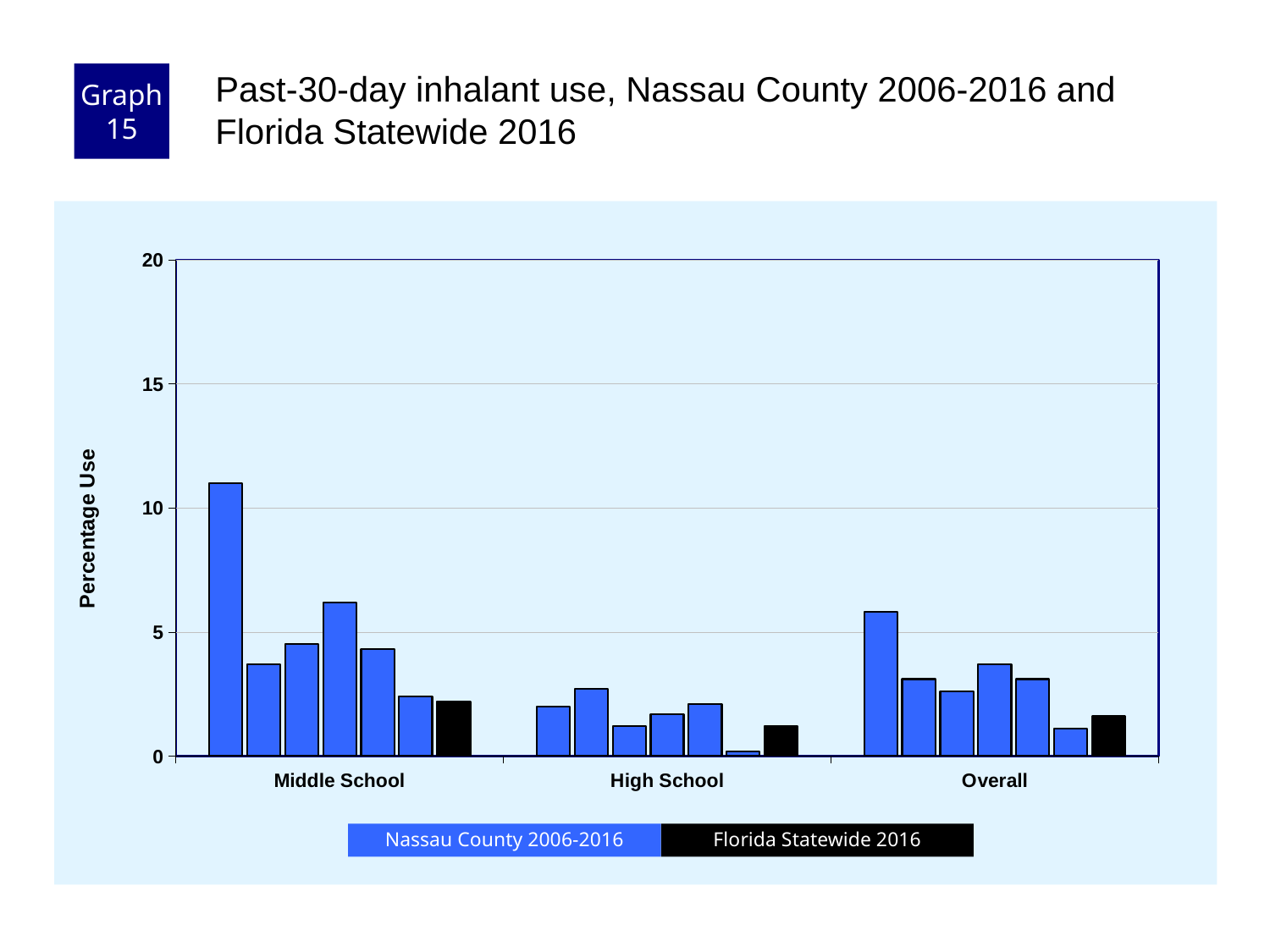
Is the tallest High School bar greater or less than 5? less Which category contains the tallest bar on the chart? Middle School How many series does the legend list? 2 How many categories are shown along the x axis? 3 Which series is shown in black? Florida Statewide 2016 Is the value of the tallest Middle School bar greater or less than 10? greater What kind of chart is shown on the slide? bar chart Is the Florida Statewide 2016 value larger for Middle School or for High School? Middle School Is the Florida Statewide 2016 value for Middle School greater or less than 5? less What is the label of the y axis? Percentage Use Which category contains the shortest bar on the chart? High School